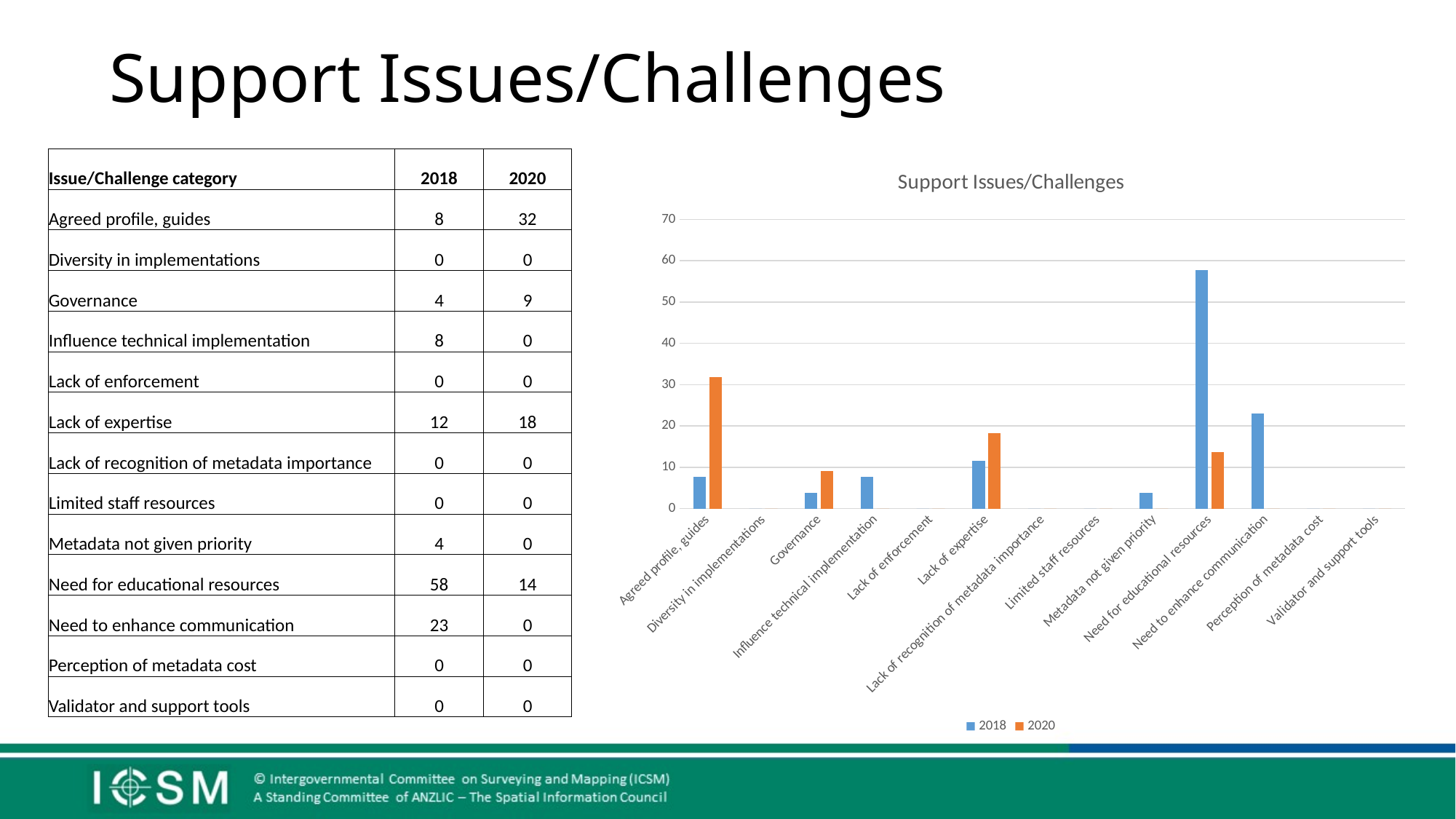
What type of chart is shown on the slide? bar chart Which is larger for Governance, the 2018 value or the 2020 value? 2020 What is the 2020 value for Lack of expertise? 18 Which colour represents the 2020 series in the chart? orange Which category has the highest value for 2020? Agreed profile, guides How many series does the chart legend list? 2 What is the 2018 value for Need for educational resources? 58 What is the difference between the 2018 and 2020 values for Need for educational resources? 44 What is the title of the chart? Support Issues/Challenges Which category has the highest value for 2018? Need for educational resources How many categories are shown on the x axis of the chart? 13 Is the 2018 value for Need to enhance communication greater or less than 20? greater